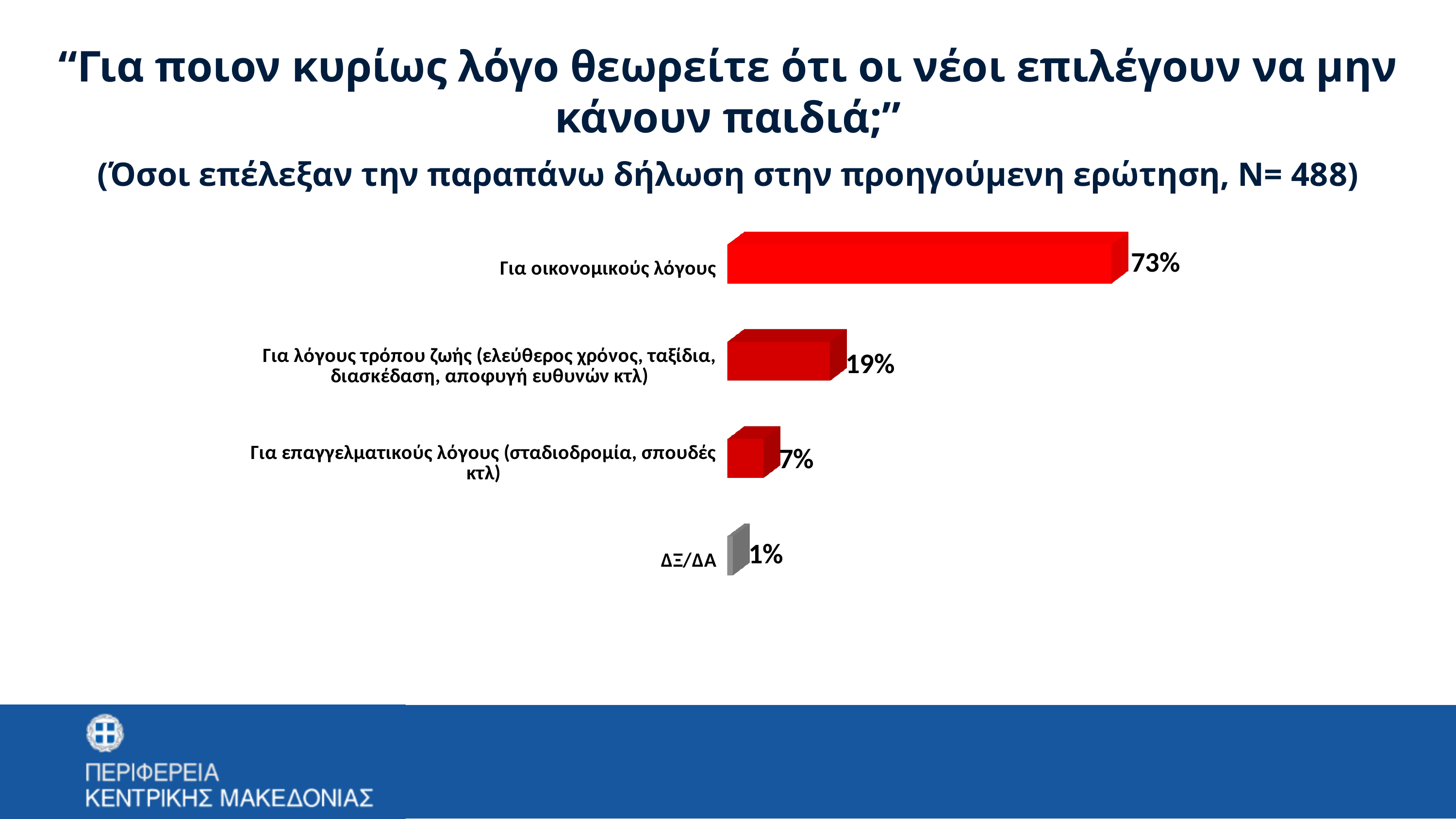
What is the difference between the value for "Για οικονομικούς λόγους" and the value for "Για λόγους τρόπου ζωής"? 54% What is the value for "Για οικονομικούς λόγους"? 73% What is the value for "ΔΞ/ΔΑ"? 1% What colour is the bar for "ΔΞ/ΔΑ"? Grey How many categories are shown in the chart? 4 Which category has the highest value? Για οικονομικούς λόγους Which category has the lowest value? ΔΞ/ΔΑ What is the value for "Για επαγγελματικούς λόγους (σταδιοδρομία, σπουδές κτλ)"? 7% Which is larger: the value for "Για επαγγελματικούς λόγους" or the value for "ΔΞ/ΔΑ"? Για επαγγελματικούς λόγους What kind of chart is shown on the slide? Bar chart What is the value for "Για λόγους τρόπου ζωής (ελεύθερος χρόνος, ταξίδια, διασκέδαση, αποφυγή ευθυνών κτλ)"? 19% What is the difference between the value for "Για λόγους τρόπου ζωής" and the value for "Για επαγγελματικούς λόγους"? 12%